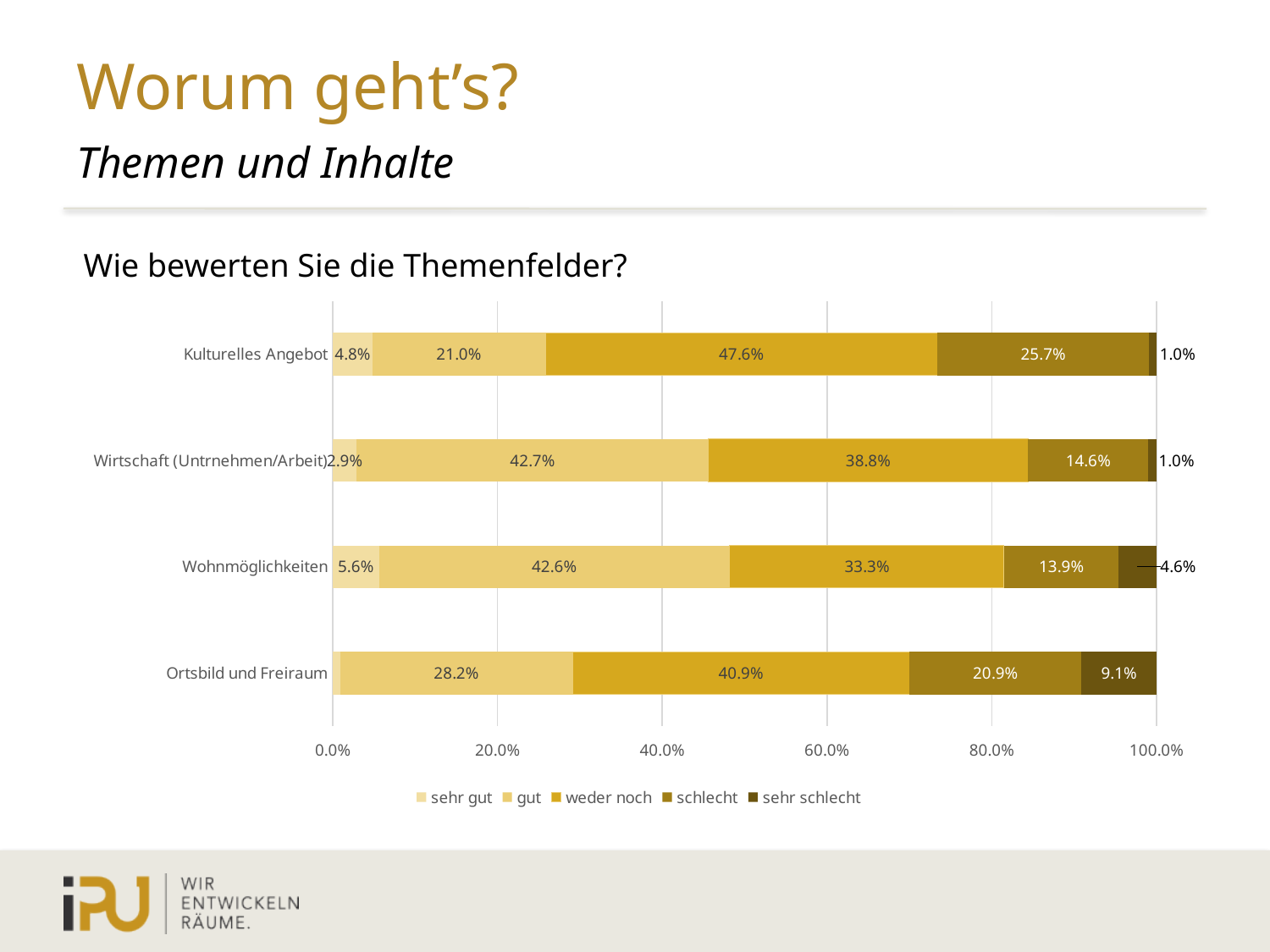
Which category has the highest 'weder noch' value? Kulturelles Angebot What is the difference between the 'schlecht' values for Kulturelles Angebot and Wohnmöglichkeiten? 11.8% Which category has the lowest 'gut' value? Kulturelles Angebot What is the 'sehr schlecht' value for Wohnmöglichkeiten? 4.6% How many categories (topic areas) are shown in the chart? 4 How many series does the legend list? 5 What is the 'schlecht' value for Ortsbild und Freiraum? 20.9% What is the 'gut' value for Wirtschaft (Untrnehmen/Arbeit)? 42.7% What is the 'weder noch' value for Kulturelles Angebot? 47.6% What kind of chart is shown on the slide? stacked bar chart What is the last entry in the chart legend? sehr schlecht Which is larger: the 'sehr schlecht' value for Ortsbild und Freiraum or for Wohnmöglichkeiten? Ortsbild und Freiraum